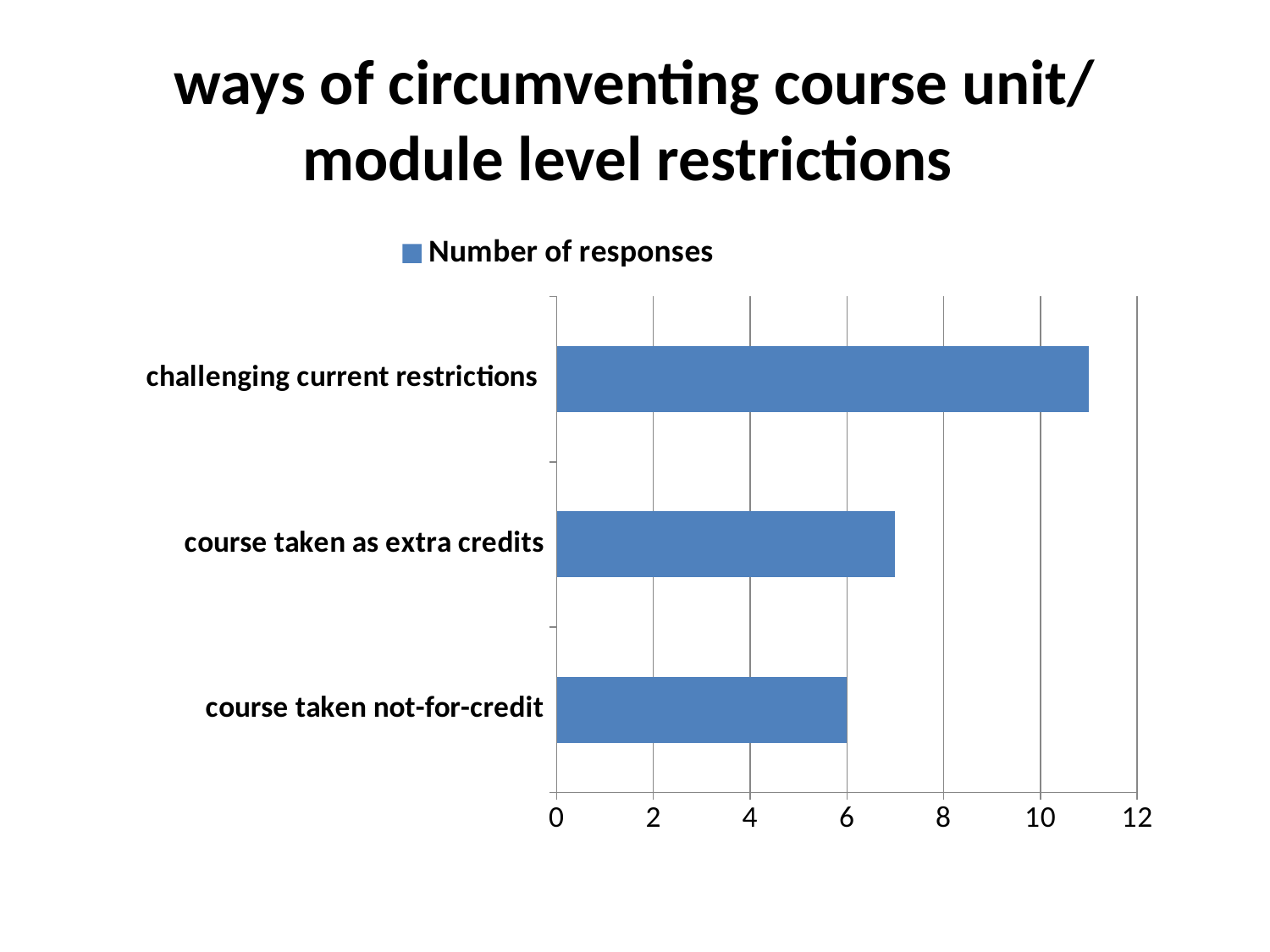
Is the value for 'challenging current restrictions' greater or less than 12? less How many series does the legend list? 1 What is the number of responses for 'course taken not-for-credit'? 6 How many categories are plotted in the chart? 3 Is the value for 'course taken as extra credits' greater or less than 8? less Which category has the lowest number of responses? course taken not-for-credit What type of chart is shown on the slide? bar chart Which has more responses: 'challenging current restrictions' or 'course taken as extra credits'? challenging current restrictions What series name is shown in the chart legend? Number of responses What is the title of the chart on the slide? ways of circumventing course unit/module level restrictions Is the value for 'challenging current restrictions' greater or less than 10? greater Which category has the highest number of responses? challenging current restrictions